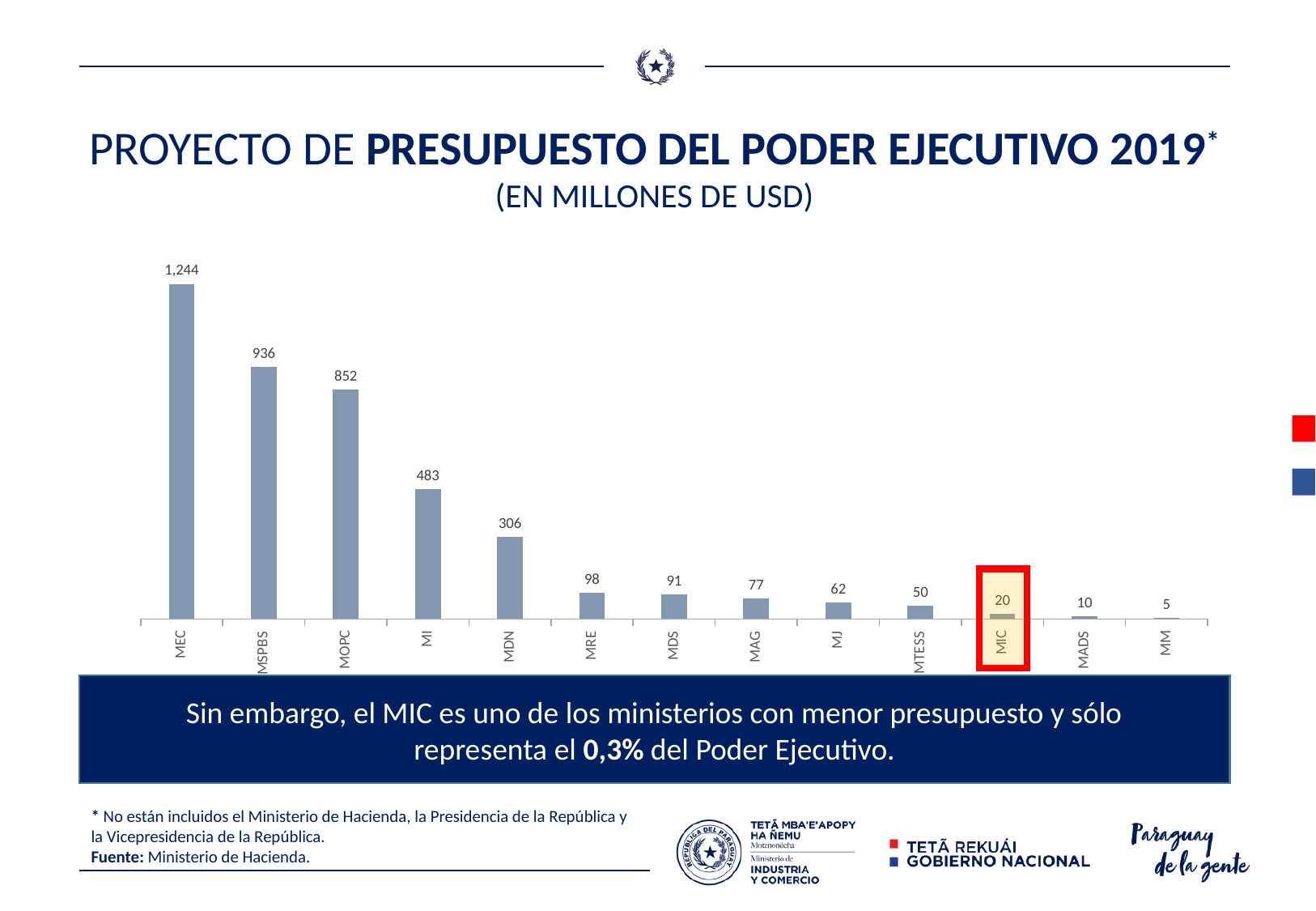
What is the value for MDN? 306 Do the values rise or fall from left to right along the x axis? fall Which category has the highest value? MEC What is the difference between the values for MI and MDN? 177 What kind of chart is shown on the slide? bar chart How many categories are shown on the x axis? 13 What is the value for MEC? 1,244 Which category's bar is highlighted with a red box? MIC Which category has the lowest value? MM What is the value for MIC? 20 What is the difference between the values for MSPBS and MOPC? 84 Which is larger, the value for MRE or the value for MDS? MRE